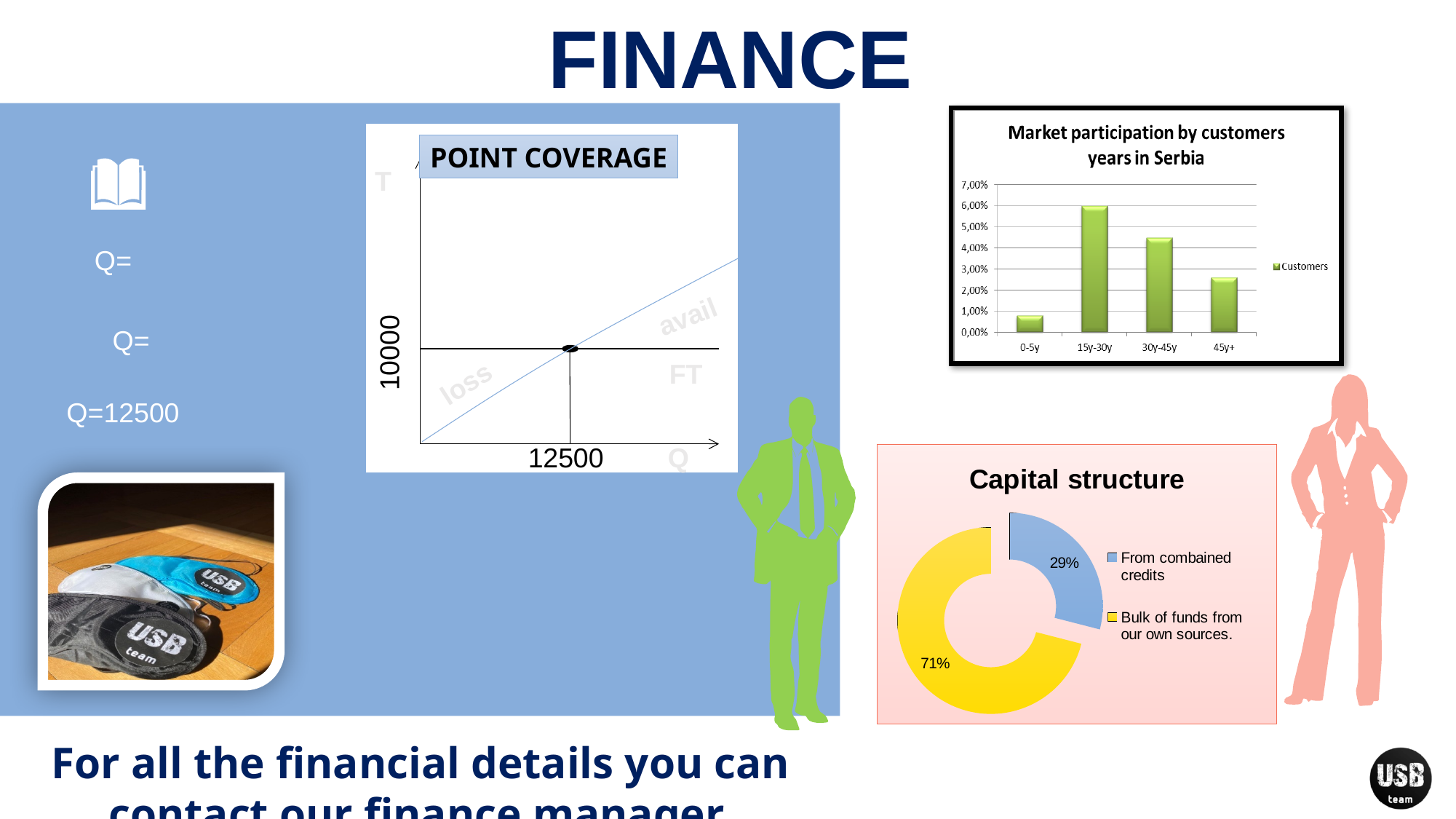
In the 'Market participation by customers years in Serbia' chart, which is larger, the value for 30y-45y or the value for 45y+? 30y-45y What kind of chart is 'Market participation by customers years in Serbia'? bar chart In the 'Market participation by customers years in Serbia' chart, which age group has the highest value? 15y-30y In the 'Capital structure' chart, what share comes from combined credits? 29% In the 'Market participation by customers years in Serbia' chart, which age group has the lowest value? 0-5y In the 'Capital structure' chart, what is the difference between the share from own sources and the share from combined credits? 42% In the 'Market participation by customers years in Serbia' chart, what series name does the legend show? Customers In the 'POINT COVERAGE' chart, what Q value is marked on the x axis at the break-even point? 12500 In the 'Market participation by customers years in Serbia' chart, is the value for 30y-45y greater or less than 4,00%? greater In the 'Market participation by customers years in Serbia' chart, how many age groups are shown on the x axis? 4 In the 'Capital structure' chart, what share is the bulk of funds from our own sources? 71% In the 'Market participation by customers years in Serbia' chart, is the value for 0-5y greater or less than 1,00%? less